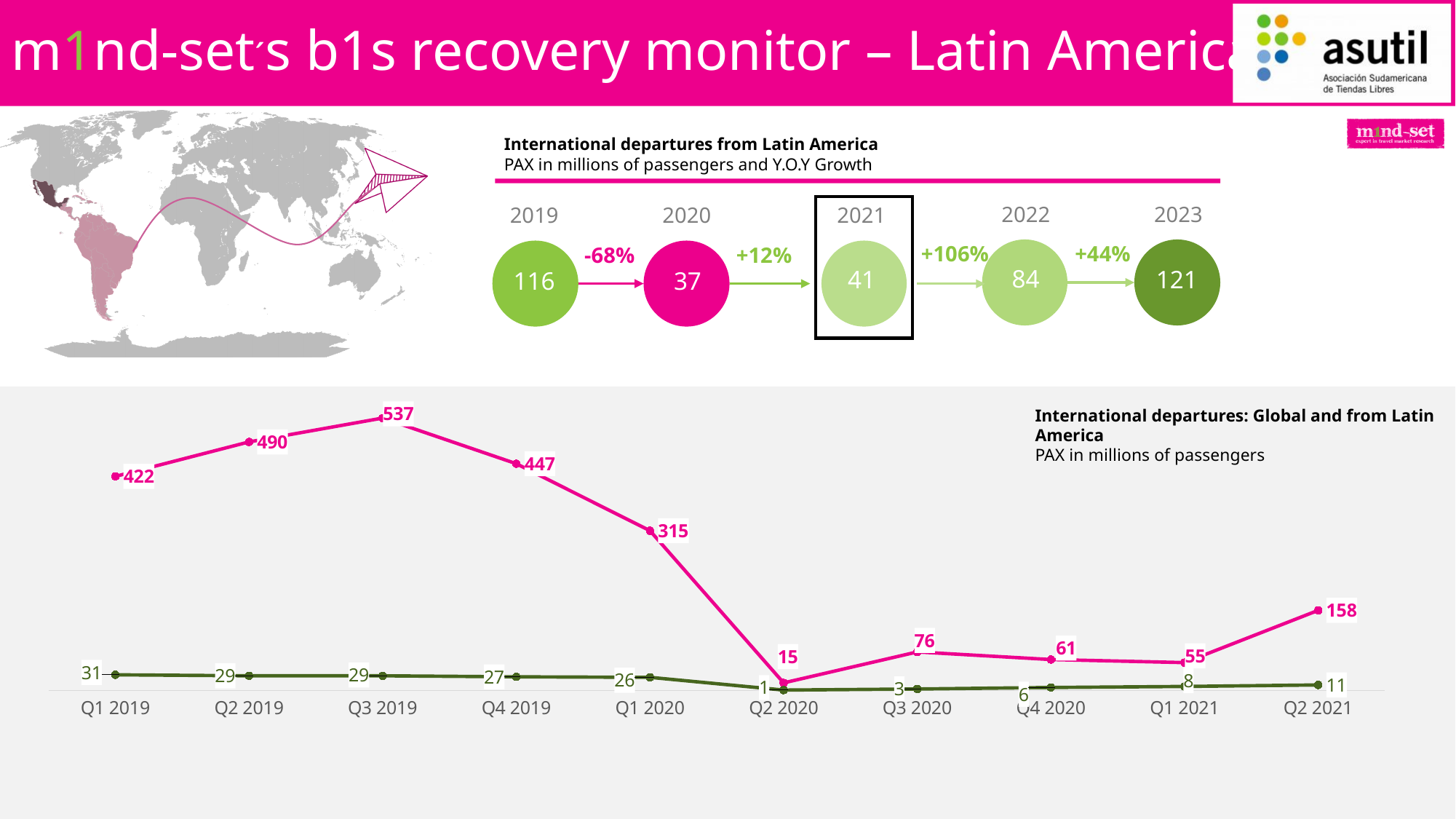
In the line chart 'International departures: Global and from Latin America', at which quarter does the pink line reach its highest value? Q3 2019 What type of chart is 'International departures: Global and from Latin America'? line chart In the line chart 'International departures: Global and from Latin America', what is the value of the pink line at Q2 2021? 158 In the line chart 'International departures: Global and from Latin America', does the green line rise or fall from Q2 2020 to Q2 2021? rise In the line chart 'International departures: Global and from Latin America', what is the difference between the pink line's values at Q1 2020 and Q2 2020? 300 In the line chart 'International departures: Global and from Latin America', which is larger for the pink line: Q3 2020 or Q4 2020? Q3 2020 How many lines are plotted in the chart 'International departures: Global and from Latin America'? 2 In the 'International departures from Latin America' diagram, what is the PAX value shown for 2022? 84 In the line chart 'International departures: Global and from Latin America', what is the value of the upper (pink) line at Q3 2019? 537 In the line chart 'International departures: Global and from Latin America', what is the value of the lower (green) line at Q1 2019? 31 How many quarters are shown on the x axis of the line chart 'International departures: Global and from Latin America'? 10 In the line chart 'International departures: Global and from Latin America', at which quarter does the green line reach its lowest value? Q2 2020